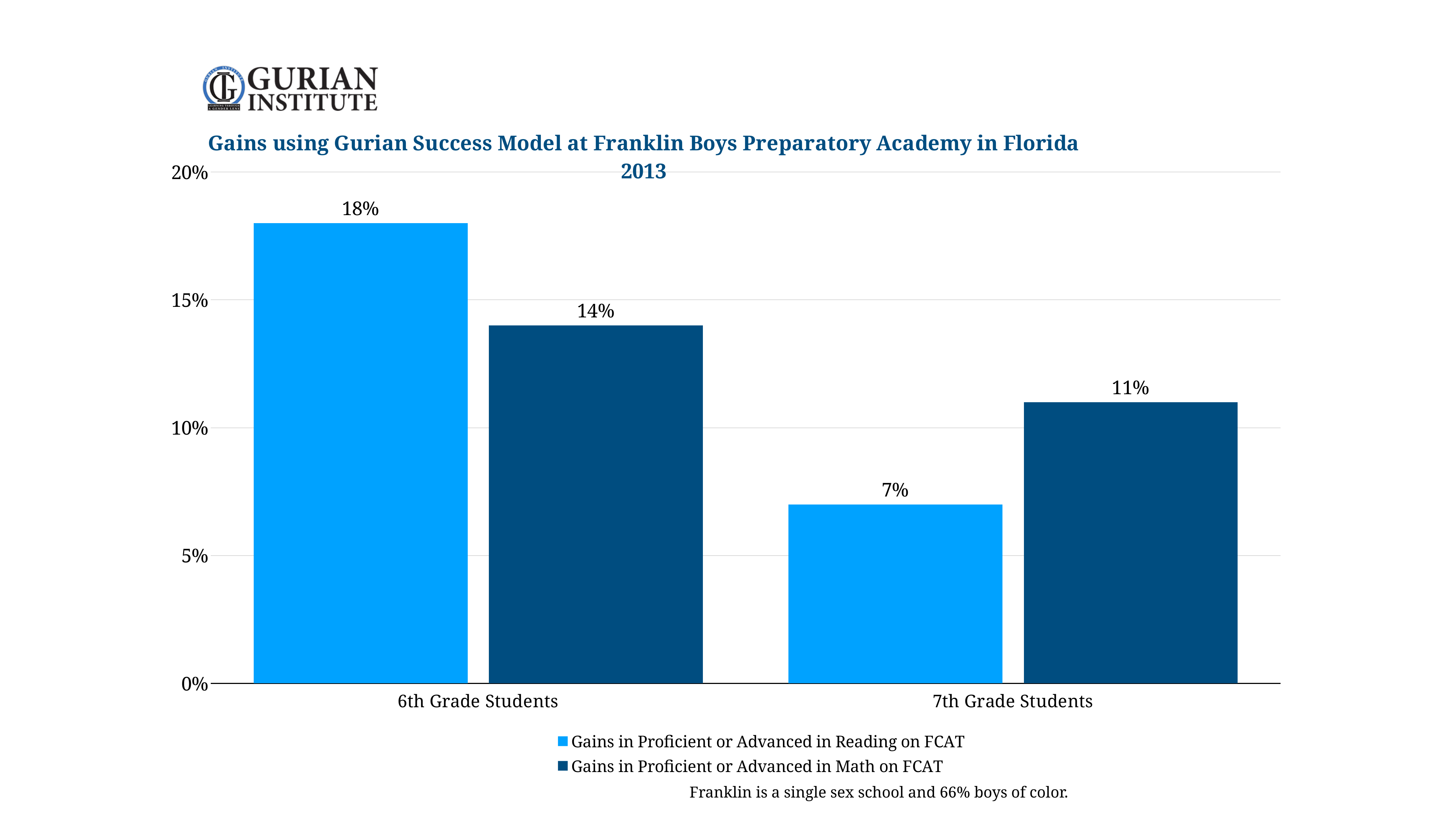
What is the math gain for 6th Grade Students? 14% What is the math gain for 7th Grade Students? 11% Which bar shows the lowest value on the chart? 7th Grade Students reading (7%) What is the difference between the reading and math gains for 6th Grade Students? 4% How many series does the legend list? 2 Which is larger for 7th Grade Students, the reading gain or the math gain? Math gain What is the reading gain for 6th Grade Students? 18% What year is shown in the chart title? 2013 What kind of chart is shown on the slide? Bar chart What is the reading gain for 7th Grade Students? 7% Which grade has the highest reading gain? 6th Grade Students How many grade categories are shown on the x axis? 2